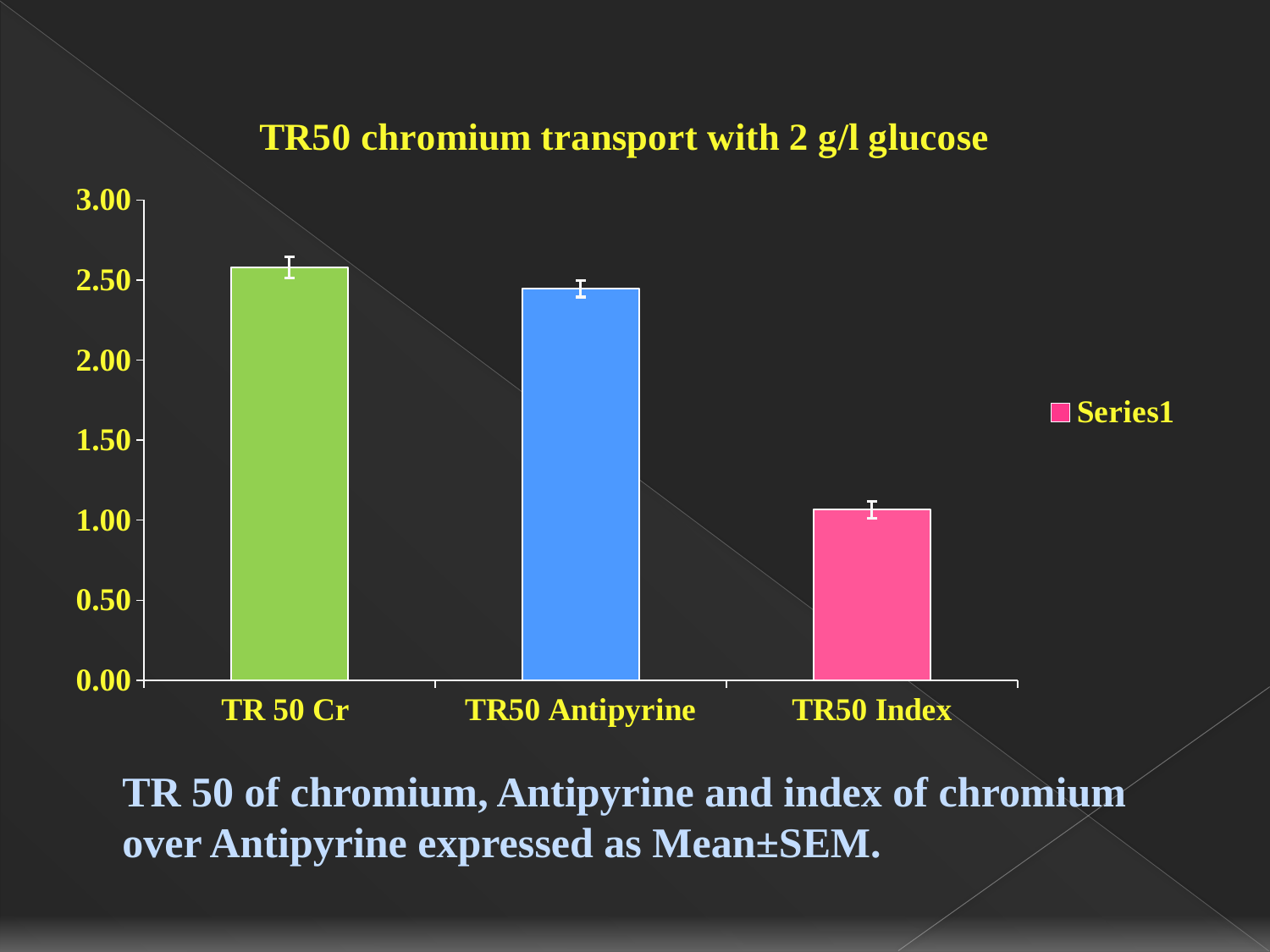
Is the value for TR50 Index greater or less than 1.50? less Is the value for TR50 Antipyrine greater or less than 2.00? greater How many categories are plotted on the x axis? 3 Do the bar values rise or fall from left to right along the x axis? fall What is the title of the chart? TR50 chromium transport with 2 g/l glucose Which category has the highest bar? TR 50 Cr Which category has the lowest bar? TR50 Index What series name is shown in the legend? Series1 Is the value for TR 50 Cr greater or less than 2.00? greater Which is larger, the value for TR 50 Cr or the value for TR50 Index? TR 50 Cr How many series does the legend list? 1 What kind of chart is shown on the slide? bar chart